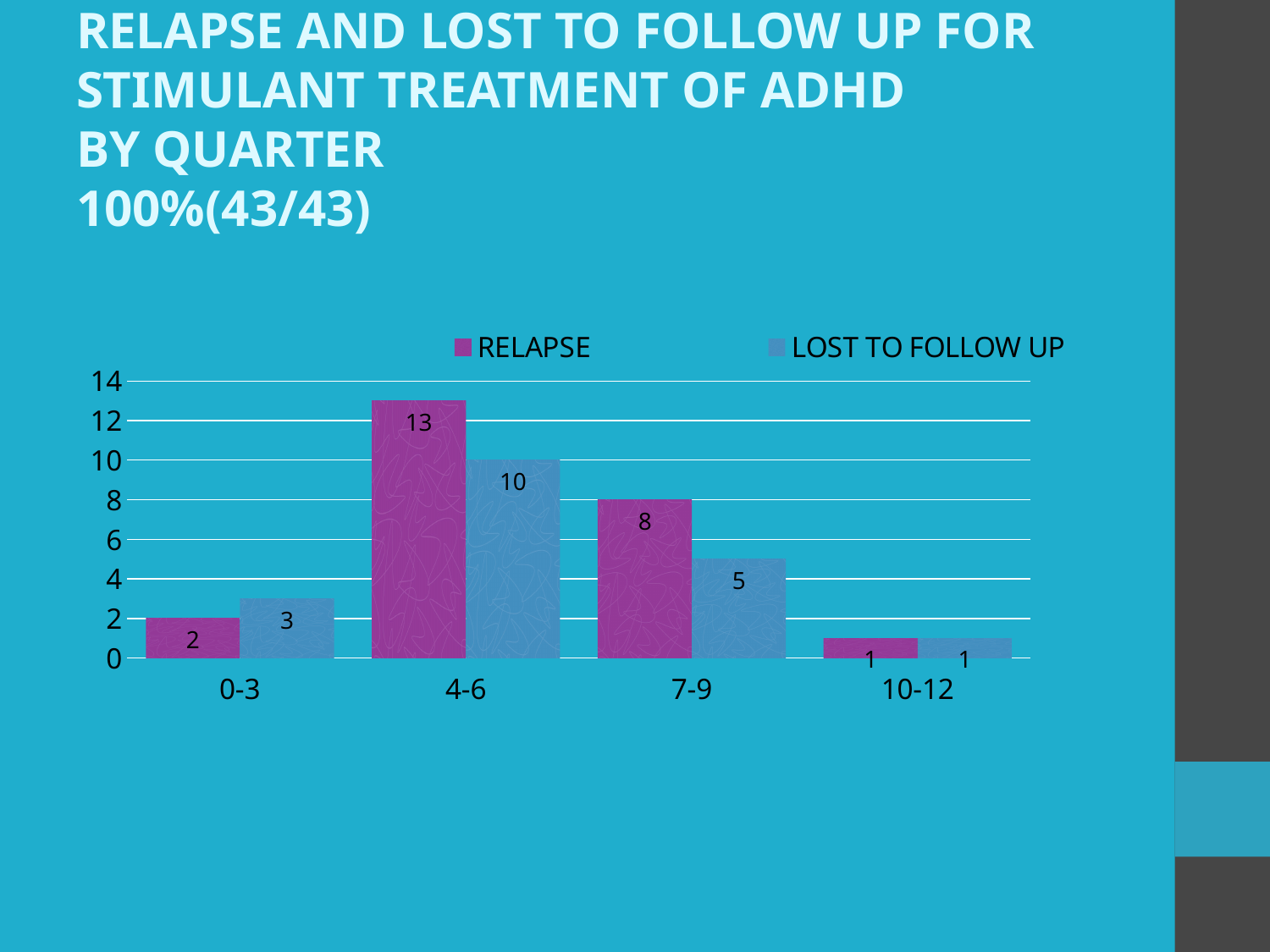
Which colour represents the RELAPSE series in the legend? Purple How many quarter categories are shown on the x axis? 4 Which is larger for the 0-3 quarter, RELAPSE or LOST TO FOLLOW UP? LOST TO FOLLOW UP What kind of chart is shown on the slide? Bar chart Which quarter has the lowest LOST TO FOLLOW UP value? 10-12 What is the RELAPSE value for the 4-6 quarter? 13 What is the LOST TO FOLLOW UP value for the 0-3 quarter? 3 What is the LOST TO FOLLOW UP value for the 7-9 quarter? 5 Which quarter has the highest RELAPSE value? 4-6 Do the RELAPSE values rise or fall from the 4-6 quarter to the 10-12 quarter? Fall What is the difference between the RELAPSE and LOST TO FOLLOW UP values for the 4-6 quarter? 3 How many series does the legend list? 2